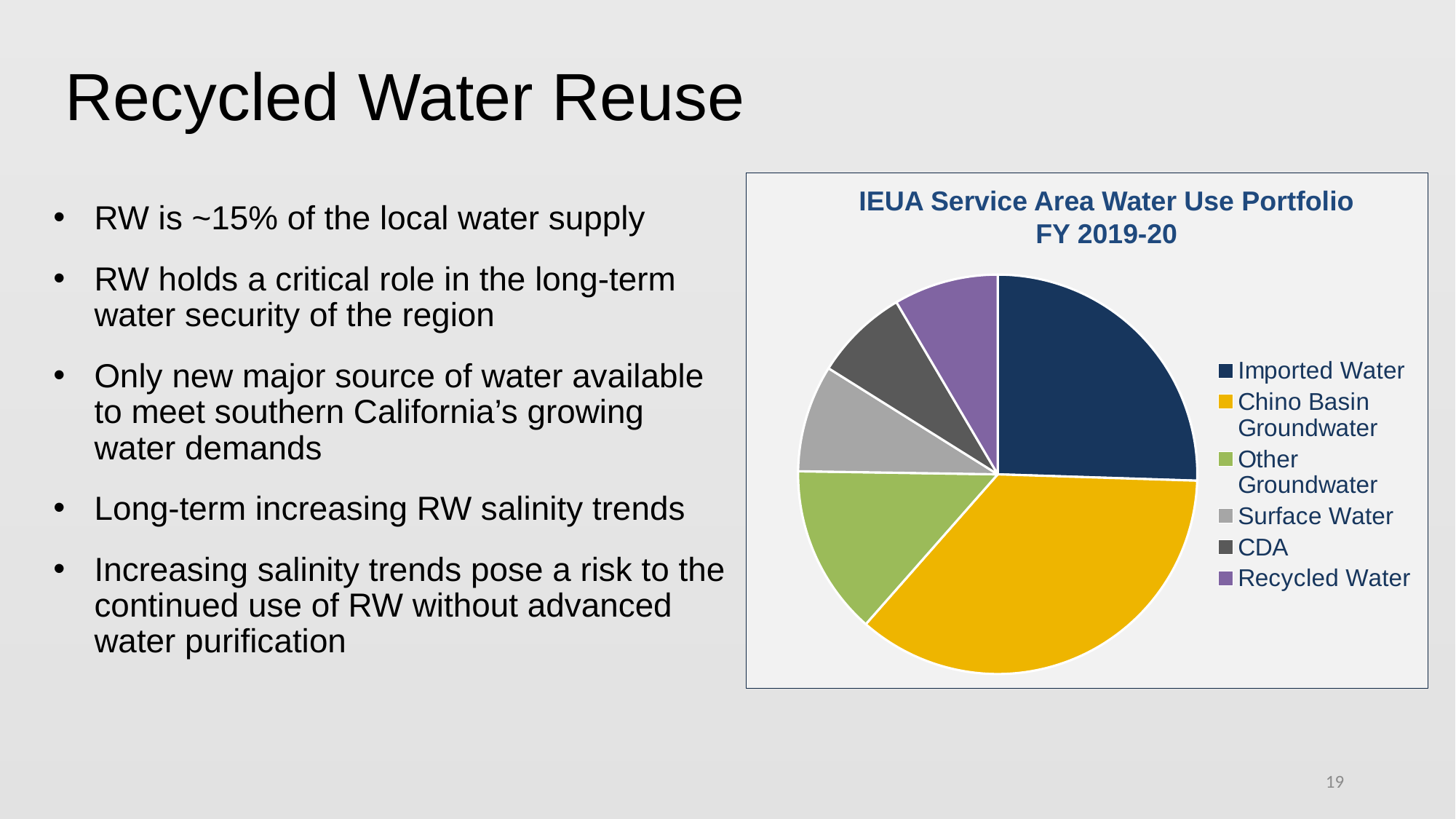
Which is larger: the slice for Other Groundwater or the slice for Recycled Water? Other Groundwater Which water source is shown in purple in the pie chart? Recycled Water How many slices does the pie chart have? 6 Which is larger: the slice for Imported Water or the slice for Other Groundwater? Imported Water How many entries does the chart legend list? 6 What is the title of the chart? IEUA Service Area Water Use Portfolio FY 2019-20 Which is larger: the slice for Chino Basin Groundwater or the slice for Imported Water? Chino Basin Groundwater What kind of chart is shown on the slide? Pie chart Which water source has the largest slice of the pie? Chino Basin Groundwater